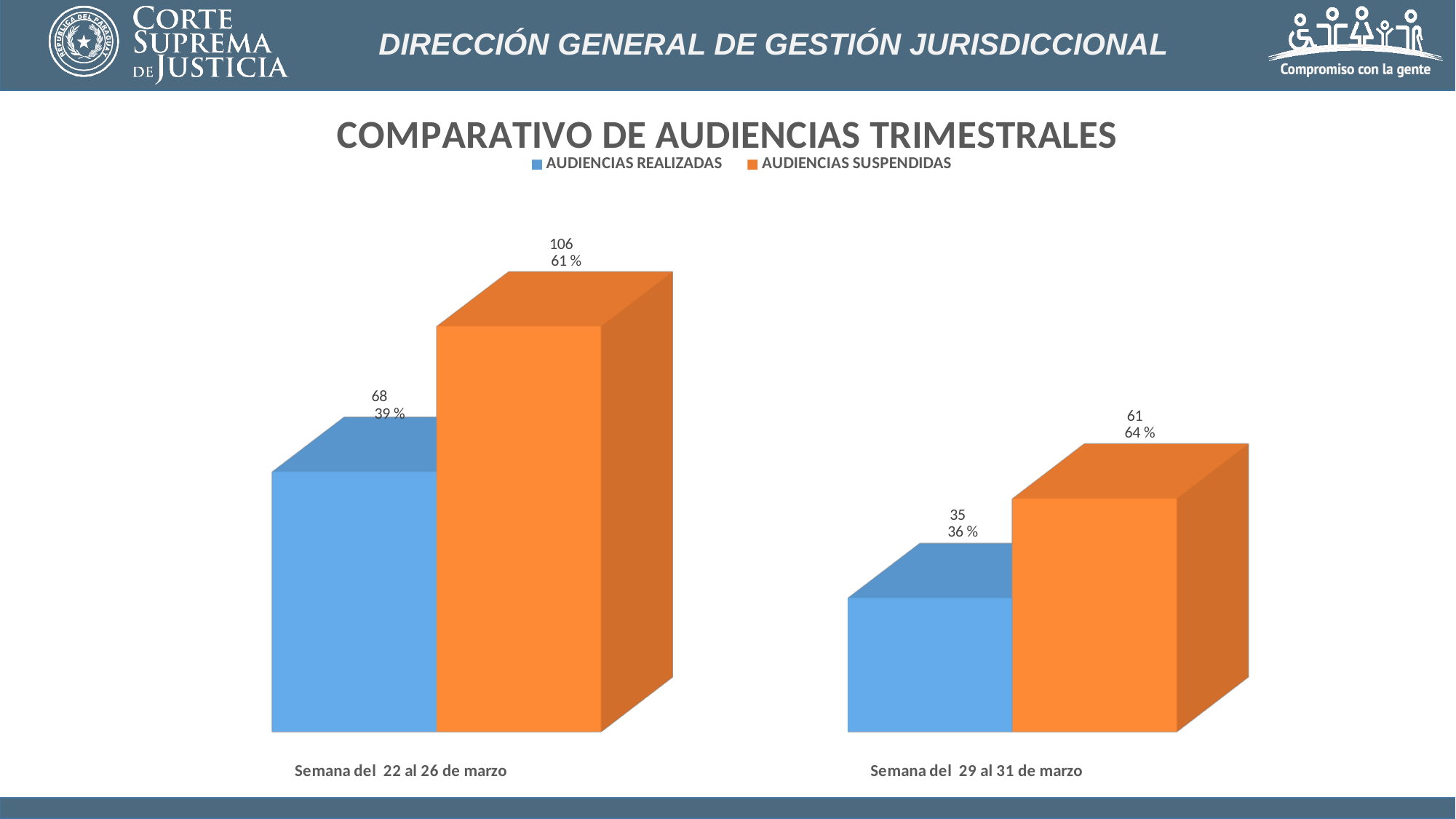
What percentage is shown for AUDIENCIAS SUSPENDIDAS in Semana del 29 al 31 de marzo? 64 % Which bar has the highest value in the chart? AUDIENCIAS SUSPENDIDAS, Semana del 22 al 26 de marzo What type of chart is shown on the slide? Bar chart Which is larger for Semana del 29 al 31 de marzo: AUDIENCIAS REALIZADAS or AUDIENCIAS SUSPENDIDAS? AUDIENCIAS SUSPENDIDAS Which bar has the lowest value in the chart? AUDIENCIAS REALIZADAS, Semana del 29 al 31 de marzo What is the value of AUDIENCIAS SUSPENDIDAS for Semana del 29 al 31 de marzo? 61 What is the difference between AUDIENCIAS SUSPENDIDAS and AUDIENCIAS REALIZADAS for Semana del 22 al 26 de marzo? 38 What is the value of AUDIENCIAS REALIZADAS for Semana del 29 al 31 de marzo? 35 What is the value of AUDIENCIAS SUSPENDIDAS for Semana del 22 al 26 de marzo? 106 What is the value of AUDIENCIAS REALIZADAS for Semana del 22 al 26 de marzo? 68 How many series does the legend list? 2 How many categories (weeks) are shown on the x axis? 2